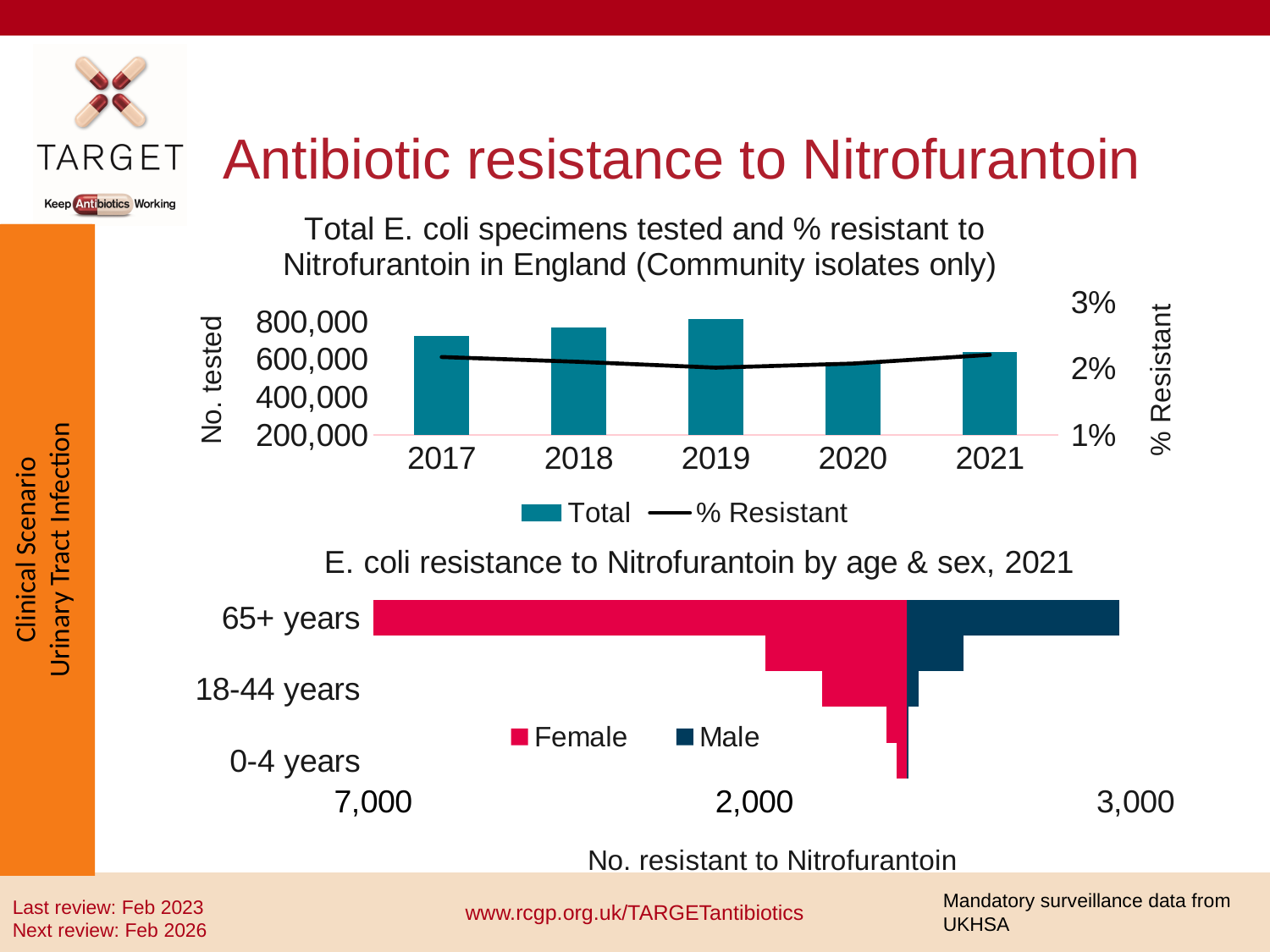
In the bottom chart (E. coli resistance to Nitrofurantoin by age & sex, 2021), what kind of chart is used? Bar chart In the top chart, is the % resistant in 2021 greater or less than 3%? less In the top chart, is the number tested in 2020 greater or less than 400,000? greater In the top chart, how many years are shown on the x axis? 5 In the top chart, is the number tested in 2017 greater or less than 600,000? greater In the top chart (Total E. coli specimens tested and % resistant), what kind of chart is used? A bar chart combined with a line chart In the top chart, how many series does the legend list? 2 In the bottom chart, which age group has the highest number of resistant female isolates? 65+ years In the top chart, which year has the lowest number of specimens tested? 2020 In the top chart, which year has the highest number of specimens tested? 2019 In the top chart, which year had more specimens tested, 2018 or 2020? 2018 In the bottom chart, what two series does the legend list? Female and Male